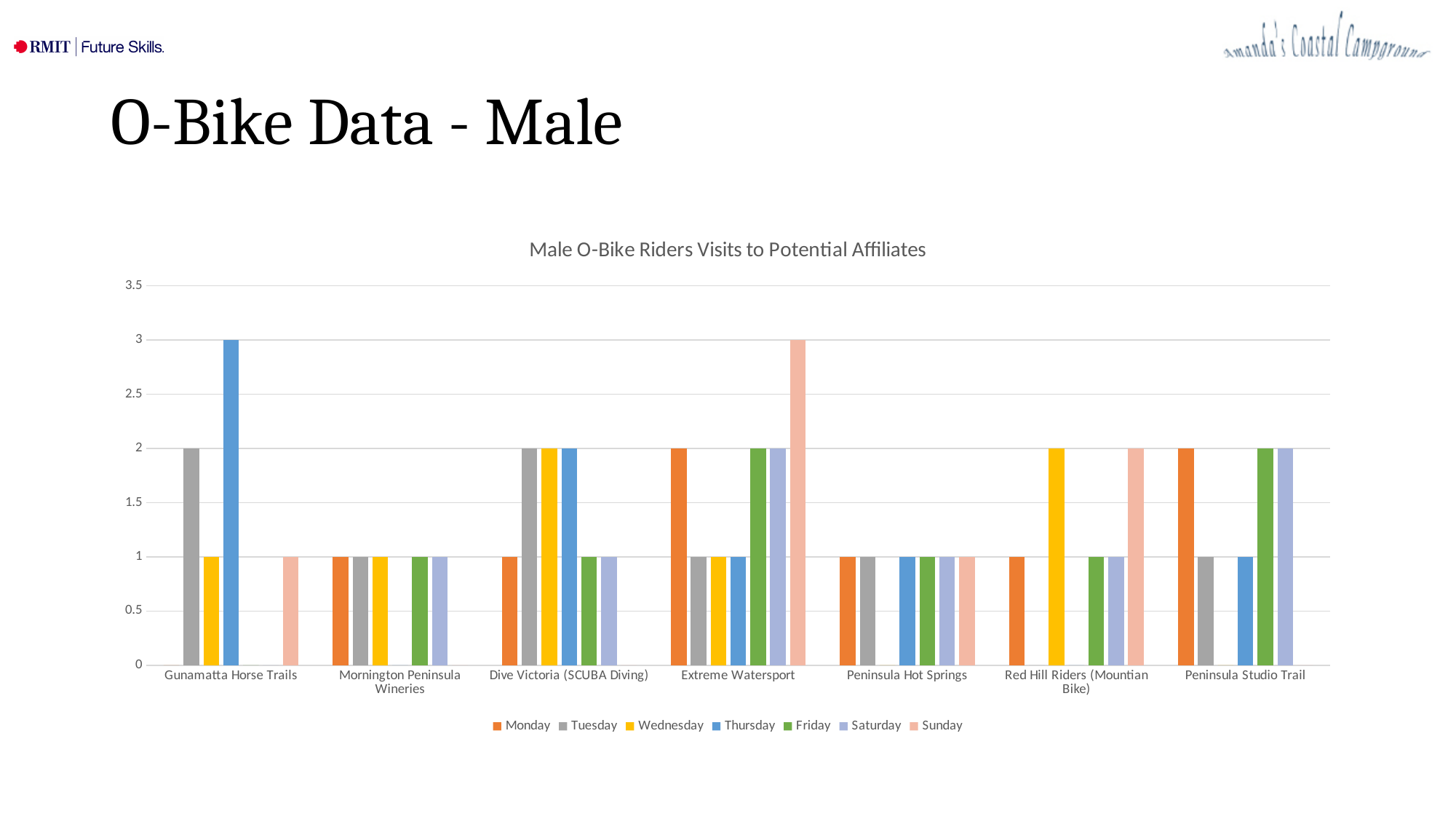
What is the value for Sunday at Extreme Watersport? 3 How many series does the legend list? 7 What kind of chart is shown on the slide? bar chart Is the value for Sunday at Extreme Watersport greater or less than 2.5? greater How many affiliate categories are shown on the x axis? 7 What is the difference between the Thursday and Wednesday values at Gunamatta Horse Trails? 2 Which is larger: the Monday value at Extreme Watersport or the Monday value at Dive Victoria (SCUBA Diving)? Extreme Watersport What is the title of the chart? Male O-Bike Riders Visits to Potential Affiliates Which day has the highest value at Extreme Watersport? Sunday Which day has the highest value at Gunamatta Horse Trails? Thursday What is the value for Wednesday at Red Hill Riders (Mountian Bike)? 2 What is the value for Thursday at Gunamatta Horse Trails? 3